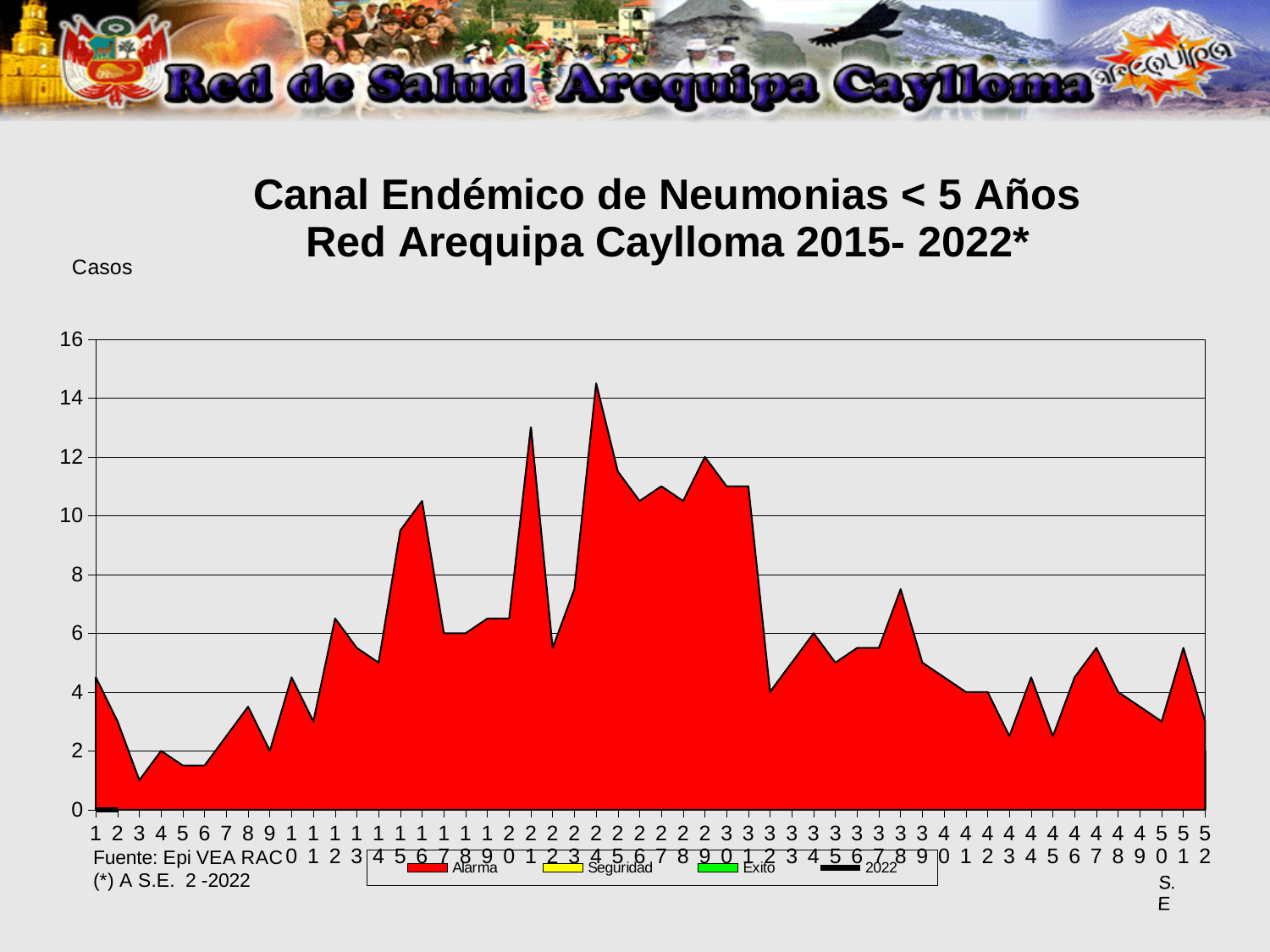
Which legend entry is shown in red? Alarma Is the value for week 32 greater or less than 6? less At which epidemiological week does the Alarma series reach its highest value? 24 Do the values rise or fall from week 24 to week 32? Fall How many series does the legend list? 4 Is the value for week 24 greater or less than 14? greater Which has the larger value, week 1 or week 3? Week 1 Is the value for week 3 greater or less than 2? less What is the label on the vertical axis of the chart? Casos Which has the larger value, week 24 or week 21? Week 24 What kind of chart is shown on the slide? Area chart